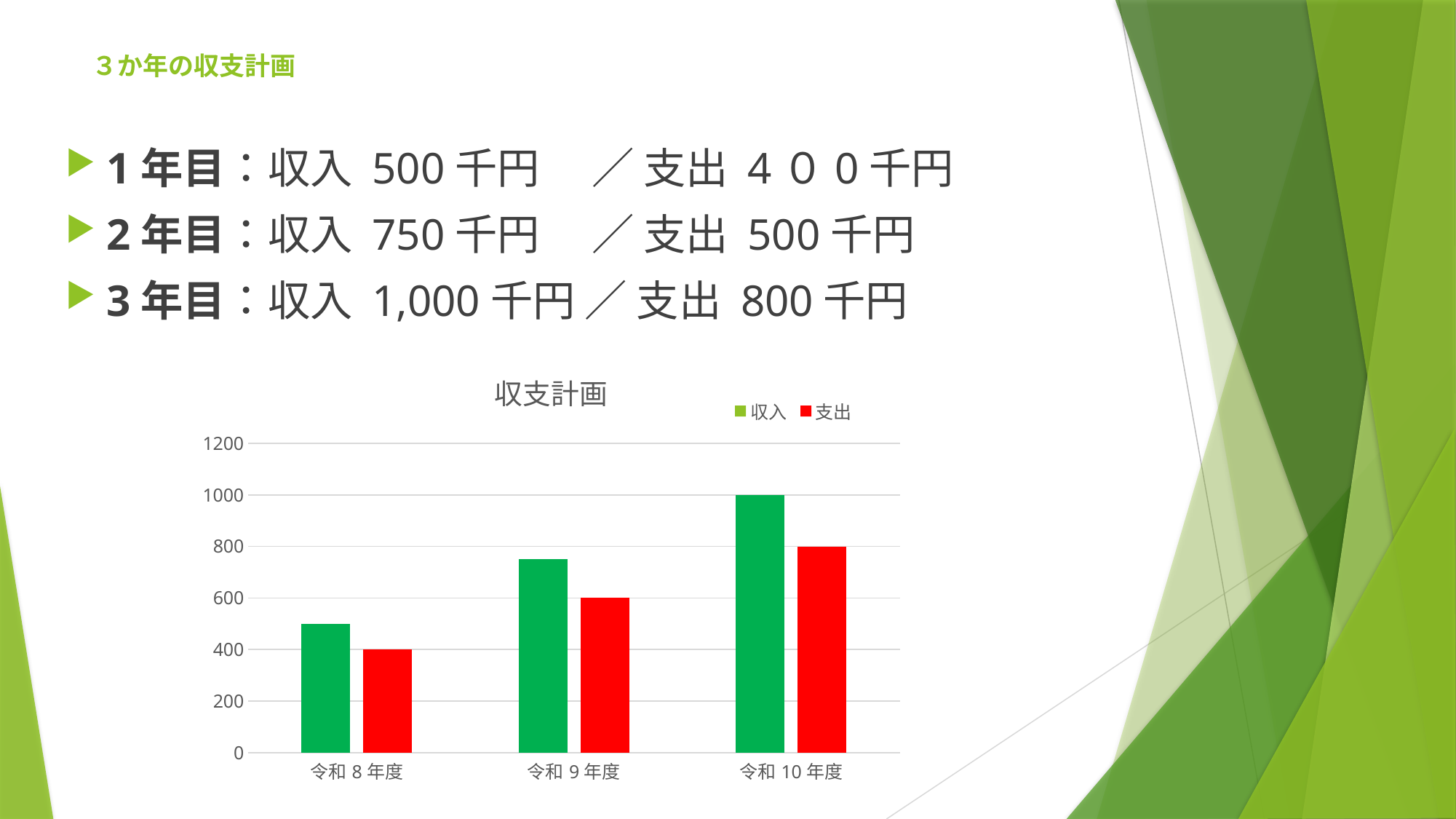
What is the difference between 収入 and 支出 for 令和10年度 in the chart? 200 Is the 収入 value for 令和8年度 greater or less than 400? greater What is the 収入 value for 令和10年度 in the chart? 1000 How many series does the legend of the 収支計画 chart list? 2 What is the 支出 value for 令和8年度 in the chart? 400 What is the 支出 value for 令和10年度 in the chart? 800 Which category has the highest 収入 value in the chart? 令和10年度 What kind of chart is shown on the slide? bar chart Which category has the lowest 支出 value in the chart? 令和8年度 Do the 収入 values rise or fall from 令和8年度 to 令和10年度? rise How many categories are shown on the x axis of the 収支計画 chart? 3 For 令和9年度, which is larger in the chart, 収入 or 支出? 収入